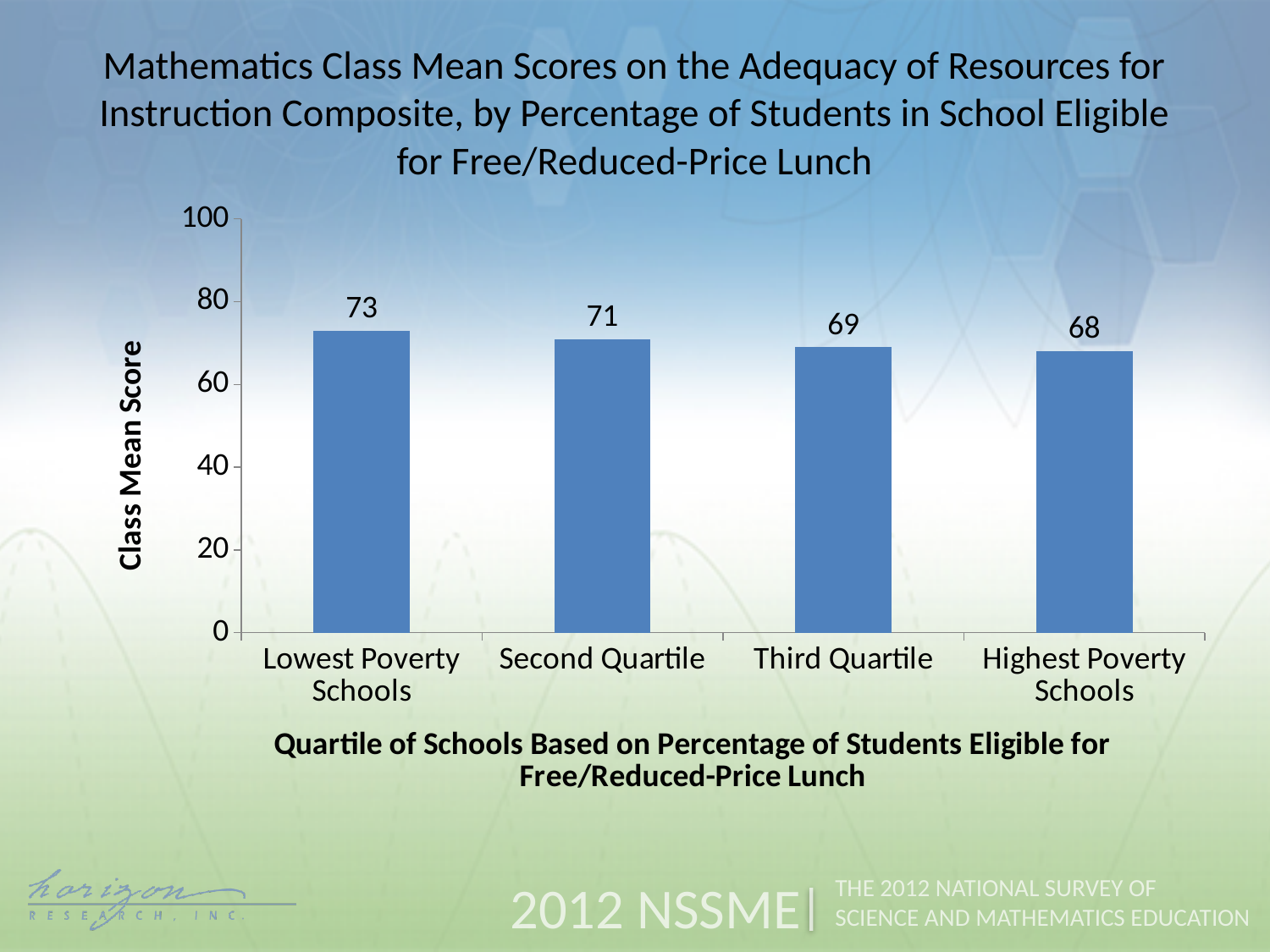
Which quartile has the highest class mean score? Lowest Poverty Schools What is the class mean score for Highest Poverty Schools? 68 What is the class mean score for Lowest Poverty Schools? 73 Which has a higher class mean score, the Second Quartile or the Third Quartile? Second Quartile What kind of chart is shown on the slide? Bar chart Is the class mean score for the Third Quartile greater or less than 80? less What is the class mean score for the Third Quartile? 69 What is the difference between the class mean scores of Lowest Poverty Schools and Highest Poverty Schools? 5 Do the class mean scores rise or fall moving from Lowest Poverty Schools to Highest Poverty Schools? Fall Which quartile has the lowest class mean score? Highest Poverty Schools How many quartile categories are shown on the chart? 4 What is the class mean score for the Second Quartile? 71